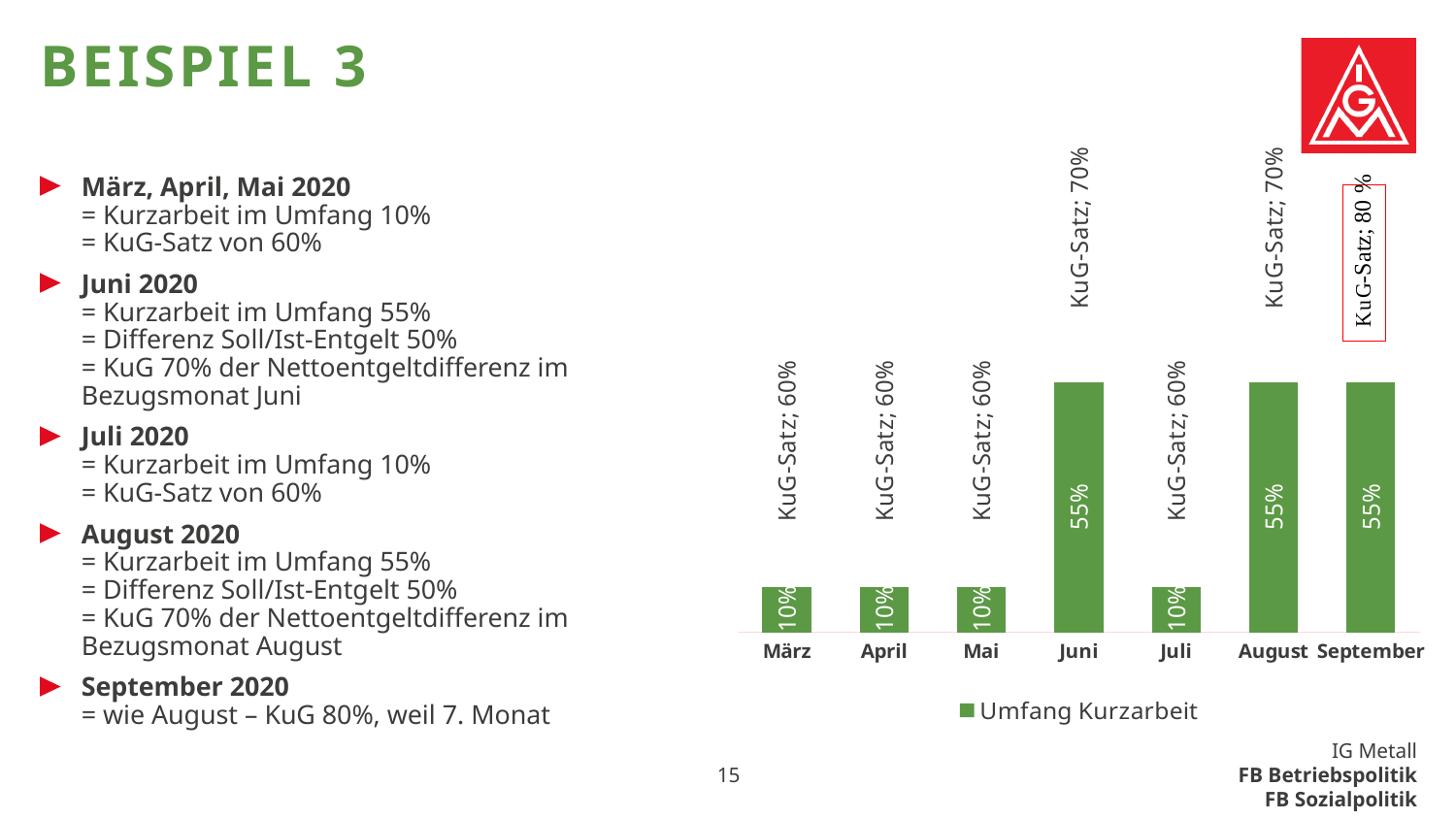
What is the legend entry of the chart? Umfang Kurzarbeit What is the difference between the values for Juni and Juli? 45% What is the value for September in the chart? 55% What KuG-Satz is shown above the bar for Juni? 70% How many series does the legend list? 1 How many months are shown on the x axis of the chart? 7 Which is larger, the value for August or the value for Mai? August What KuG-Satz is shown above the bar for April? 60% What is the value for März in the chart? 10% What KuG-Satz is shown above the bar for September? 80% What is the value for Juni in the chart? 55% What kind of chart is shown on the slide? Bar chart